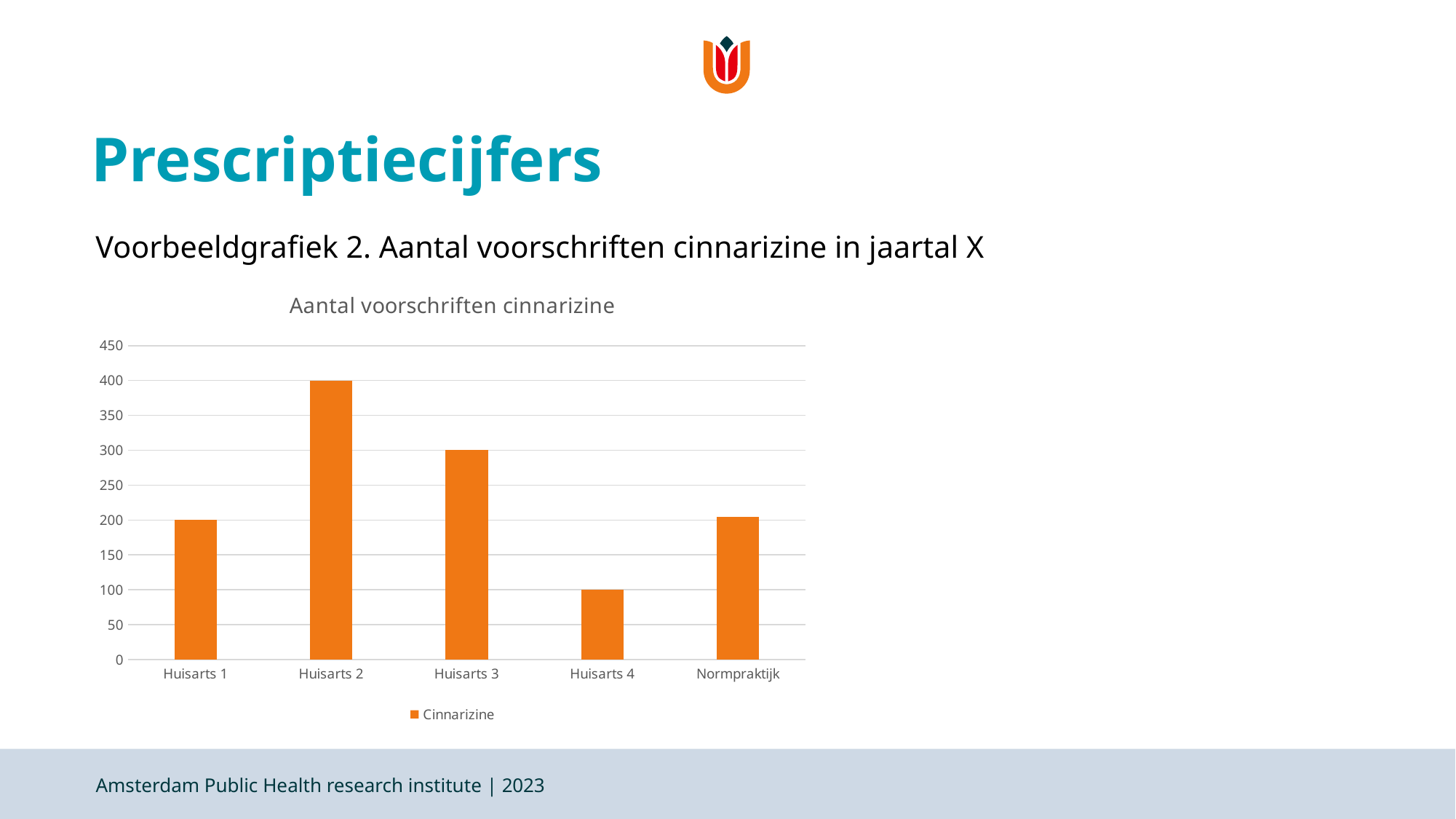
Which category has the highest value? Huisarts 2 What is the difference between the values for Huisarts 2 and Huisarts 4? 300 What is the title of the chart? Aantal voorschriften cinnarizine What is the value for Huisarts 3? 300 What is the value for Huisarts 2? 400 What type of chart is shown on the slide? bar chart Which is larger, the value for Huisarts 3 or the value for Normpraktijk? Huisarts 3 What is the value for Huisarts 1? 200 What is the value for Huisarts 4? 100 Which category has the lowest value? Huisarts 4 Is the value for Normpraktijk greater or less than 250? less How many categories are shown on the x axis? 5